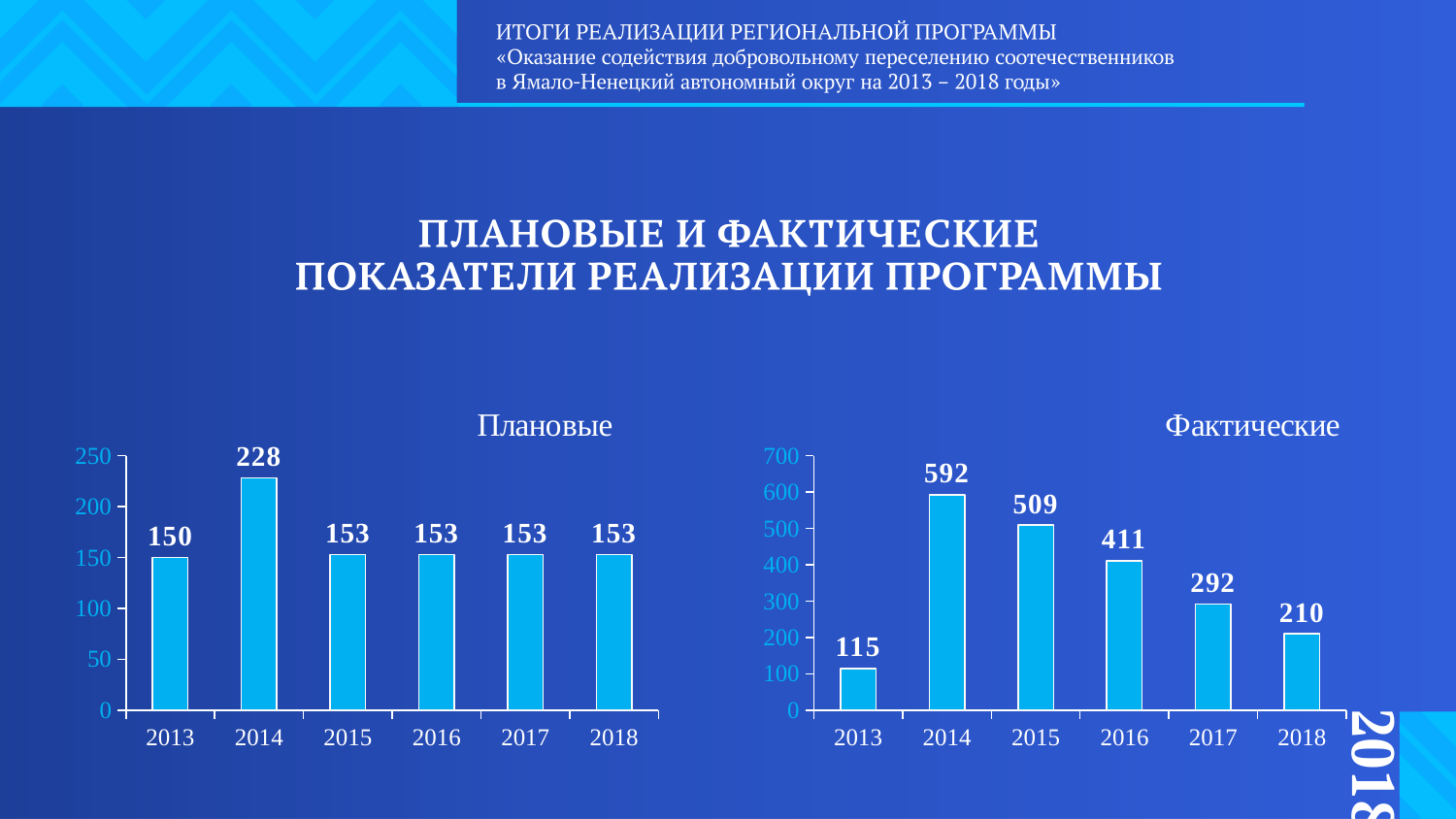
In the "Фактические" chart, do the values rise or fall from 2014 to 2018? fall In the "Фактические" chart, what is the difference between the values for 2014 and 2015? 83 In the "Фактические" chart, which is larger, the value for 2017 or the value for 2018? 2017 In the "Плановые" chart, what is the value for 2014? 228 In the "Фактические" chart, what is the value for 2016? 411 How many years are shown on the x axis of the "Плановые" chart? 6 In the "Плановые" chart, what is the difference between the values for 2014 and 2013? 78 In the "Плановые" chart, which year has the lowest value? 2013 In the "Фактические" chart, which year has the highest value? 2014 In the "Фактические" chart, which year has the lowest value? 2013 In the "Фактические" chart, is the value for 2015 greater or less than 400? greater What kind of chart is the "Фактические" chart? bar chart